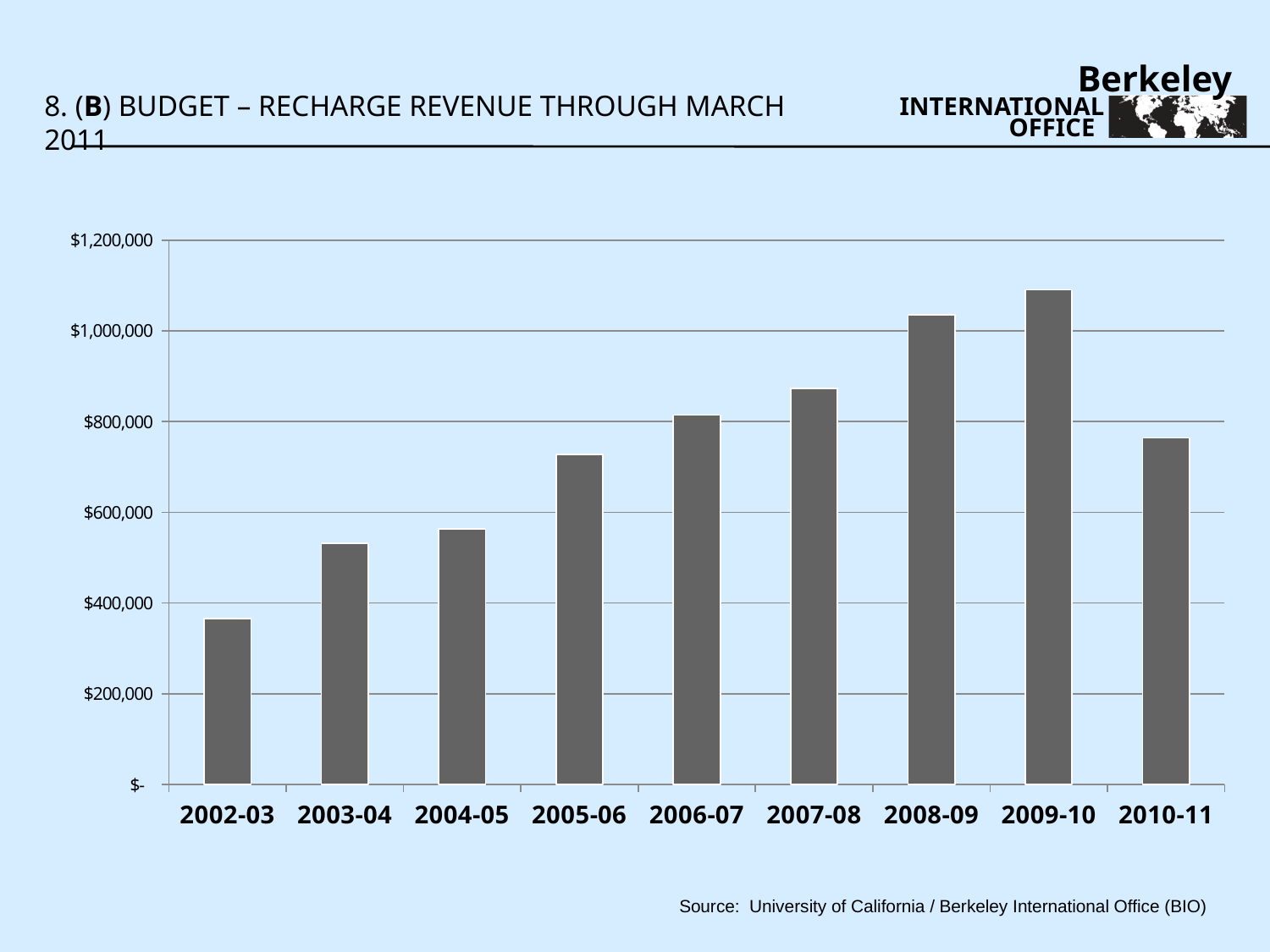
What kind of chart is shown on the slide? Bar chart Which fiscal year has the lowest recharge revenue? 2002-03 Is the value for 2005-06 greater or less than $600,000? greater What is the source cited below the chart? University of California / Berkeley International Office (BIO) How many fiscal years are shown on the x axis of the chart? 9 Is the value for 2002-03 greater or less than $400,000? less Is the value for 2010-11 greater or less than $800,000? less Which fiscal year has the highest recharge revenue? 2009-10 Which is larger, the value for 2008-09 or the value for 2010-11? 2008-09 How do the values change from 2002-03 through 2009-10? They rise each year